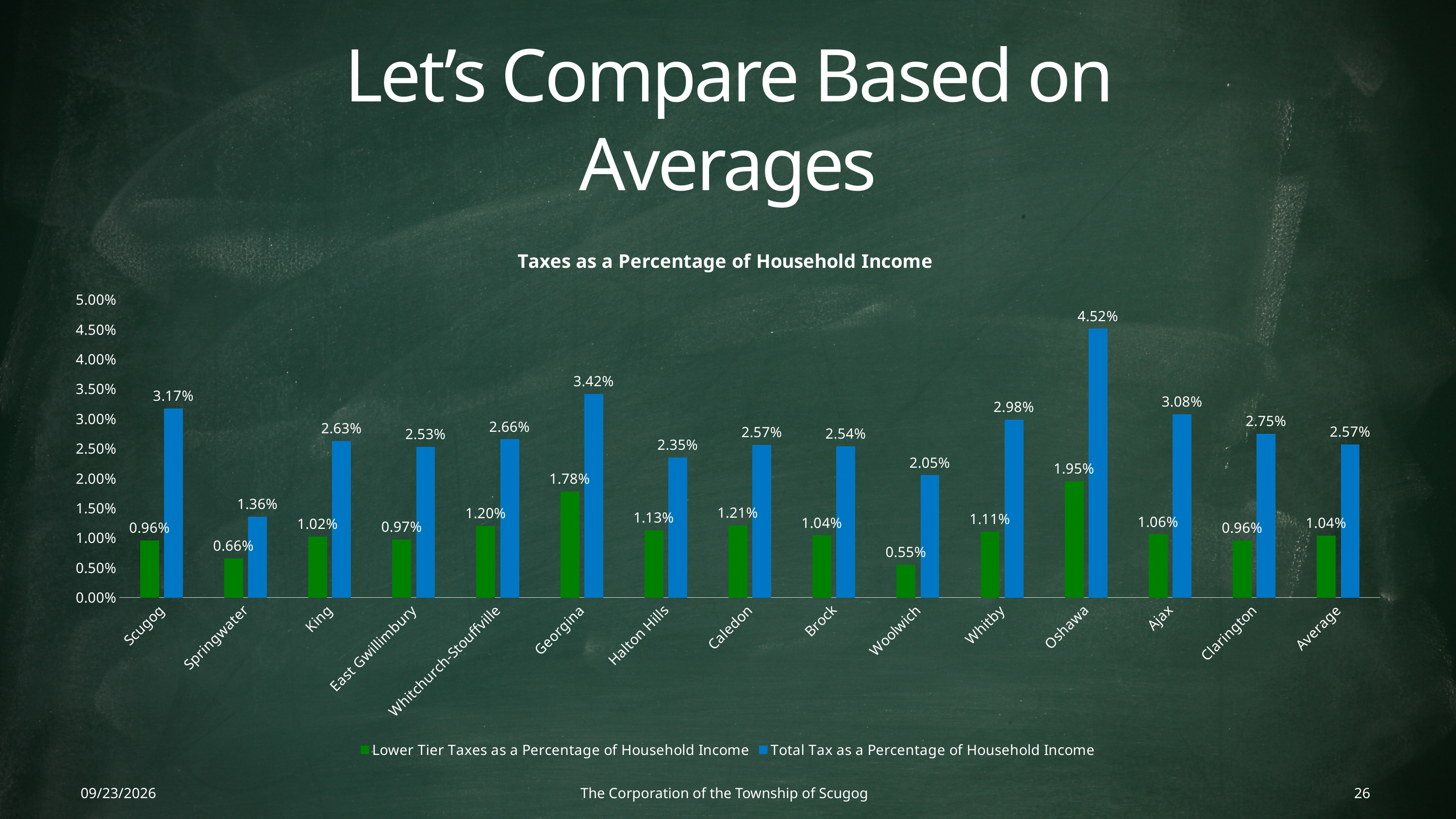
What is the difference between Oshawa's Total Tax and Lower Tier Taxes as a Percentage of Household Income? 2.57% What type of chart is shown on the slide? Bar chart How many categories are shown on the x axis of the chart? 15 Which has a higher Total Tax as a Percentage of Household Income, Scugog or Ajax? Scugog Which municipality has the lowest Lower Tier Taxes as a Percentage of Household Income? Woolwich What is the Total Tax as a Percentage of Household Income for Scugog? 3.17% Which municipality has the lowest Total Tax as a Percentage of Household Income? Springwater What is the Total Tax as a Percentage of Household Income for the Average category? 2.57% Is the Total Tax as a Percentage of Household Income for Georgina greater or less than 3.00%? greater How many series does the chart legend list? 2 Which municipality has the highest Total Tax as a Percentage of Household Income? Oshawa What is the Lower Tier Taxes as a Percentage of Household Income value for Woolwich? 0.55%